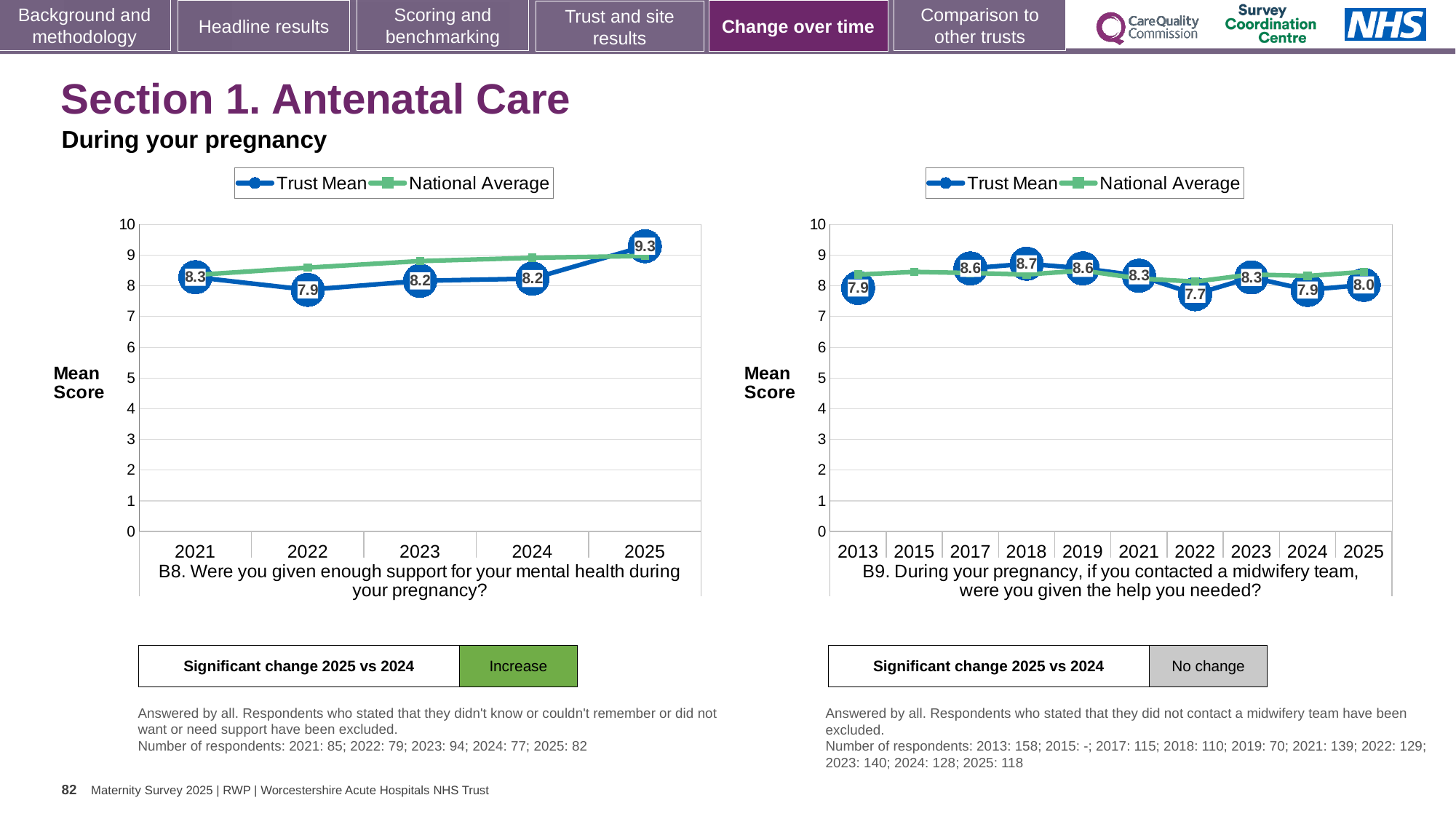
In the B8 chart on the left, which year has the highest Trust Mean? 2025 In the B8 chart on the left, is the National Average for 2021 greater or less than 7? greater In the B9 chart on the right, is the Trust Mean for 2019 or 2024 larger? 2019 In the B9 chart on the right, how many years are shown on the x axis? 10 In the B8 chart on the left, how many series does the legend list? 2 In the B9 chart on the right, what is the Trust Mean for 2018? 8.7 In the B8 chart on the left, what is the difference between the Trust Mean for 2025 and 2024? 1.1 What does the box below the B9 chart on the right say about the significant change 2025 vs 2024? No change In the B8 chart on the left, what is the Trust Mean for 2022? 7.9 In the B9 chart on the right, which year has the lowest Trust Mean? 2022 In the B8 chart on the left, what is the Trust Mean for 2025? 9.3 What kind of chart is the B9 chart on the right? Line chart